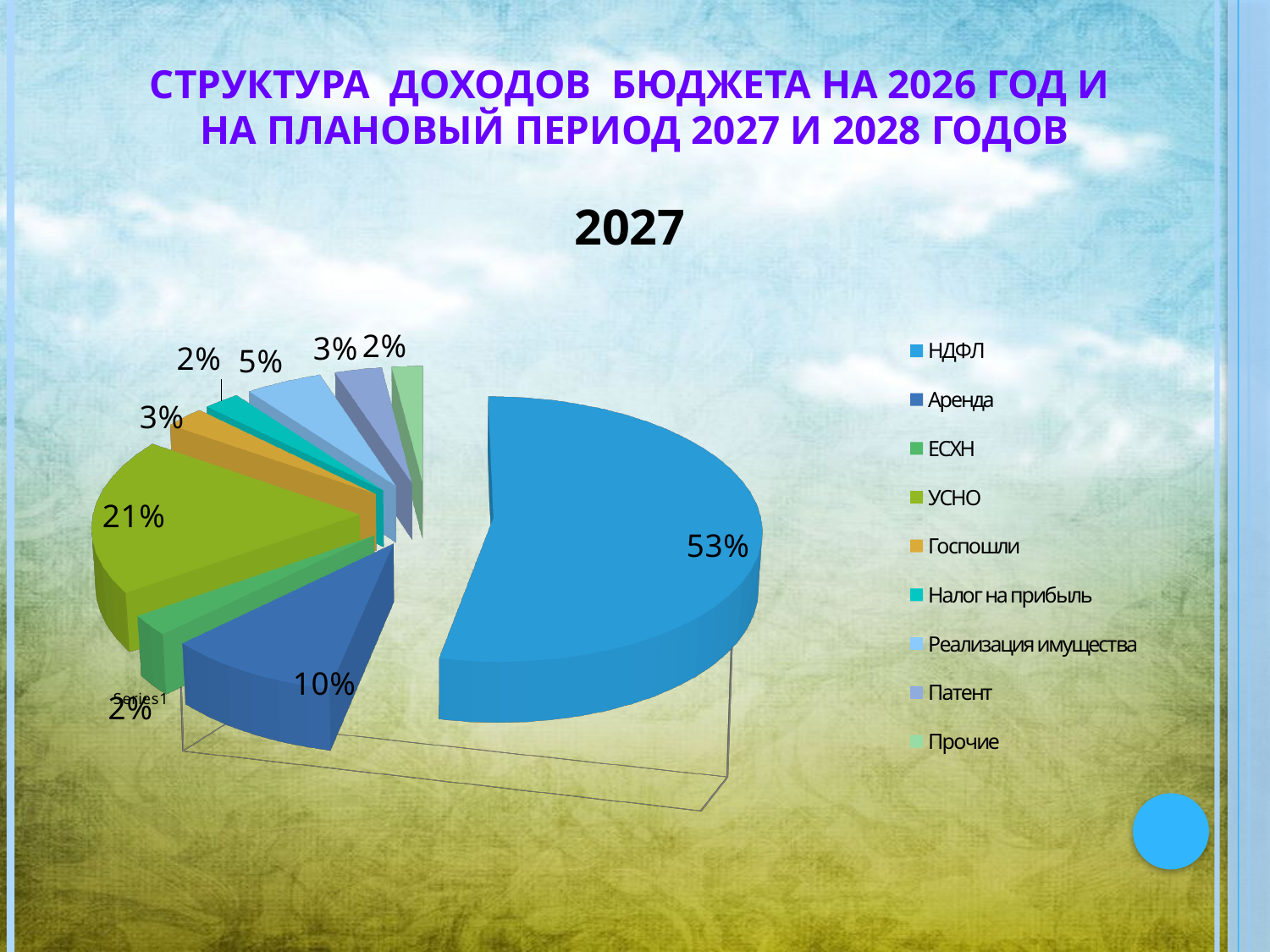
What is the title of the pie chart? 2027 Which category has the largest share in the 2027 pie chart? НДФЛ How many categories does the legend of the 2027 pie chart list? 9 What is the difference between the shares of УСНО and Аренда in the 2027 pie chart? 11% What is the share of НДФЛ in the 2027 pie chart? 53% What is the share of Реализация имущества in the 2027 pie chart? 5% What kind of chart is shown on the slide? pie chart Which legend entry is listed last in the 2027 pie chart? Прочие What is the difference between the shares of НДФЛ and УСНО in the 2027 pie chart? 32% Which is larger in the 2027 pie chart, УСНО or Аренда? УСНО What is the share of УСНО in the 2027 pie chart? 21% What is the share of Аренда in the 2027 pie chart? 10%